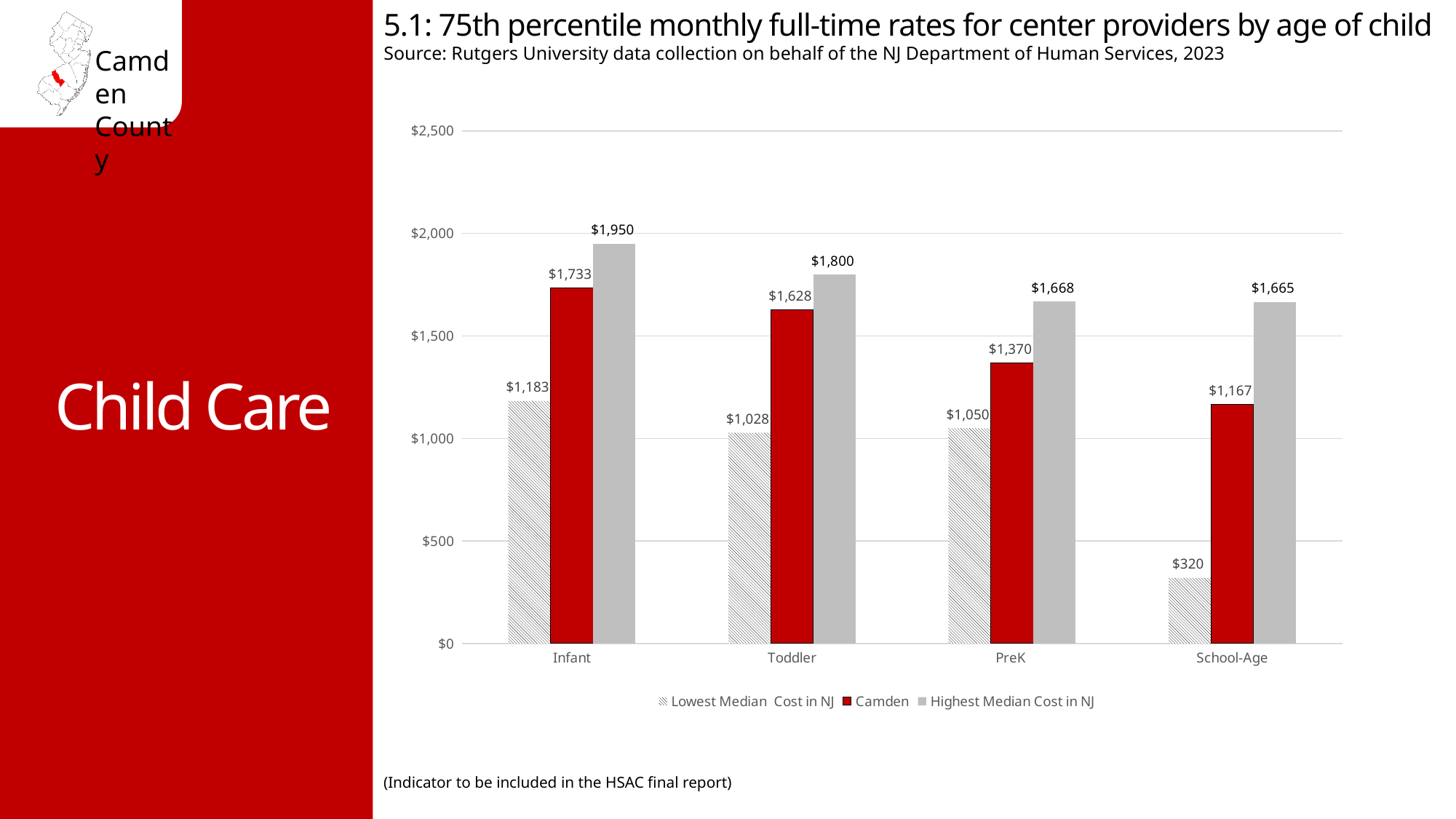
What is the difference between the Highest Median Cost in NJ and the Camden value for PreK? $298 Which is larger for Toddler: the Camden value or the Lowest Median Cost in NJ value? Camden What kind of chart is shown on the slide? bar chart Which age group has the lowest Lowest Median Cost in NJ value? School-Age Which age group has the highest Camden value? Infant What is the Camden value for Infant? $1,733 How many age groups are shown on the x axis? 4 Does the Camden series rise or fall from Infant to School-Age? fall How many series does the legend list? 3 What is the Lowest Median Cost in NJ for School-Age? $320 What is the Highest Median Cost in NJ for Toddler? $1,800 Is the Camden value for School-Age greater or less than $1,000? greater